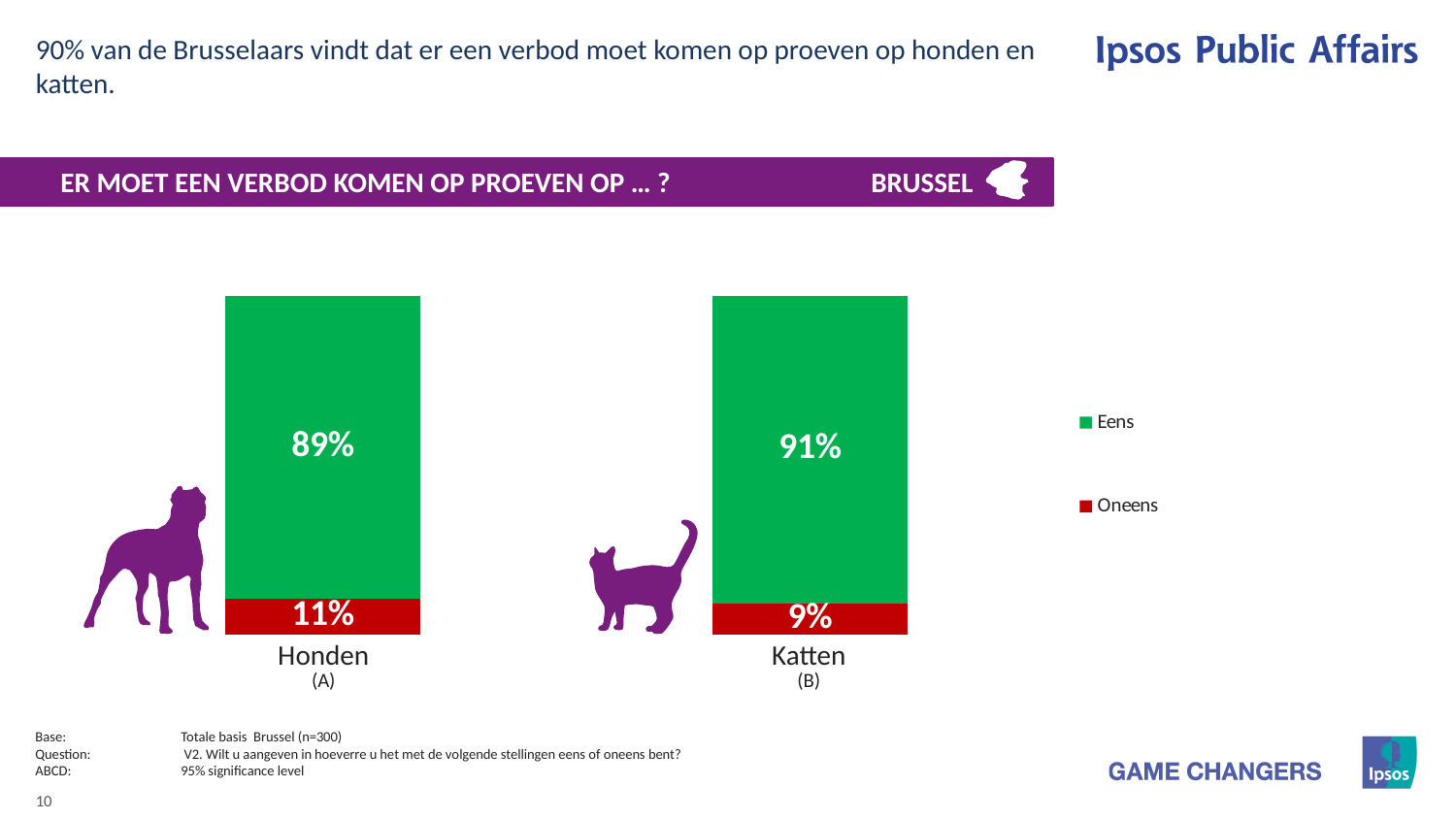
Which colour represents 'Oneens' in the legend? Red Which category has the lowest 'Oneens' value? Katten What is the 'Oneens' value for Katten? 9% How many series does the legend list? 2 What is the 'Eens' value for Honden? 89% Which category has the higher 'Eens' value, Honden or Katten? Katten What is the 'Oneens' value for Honden? 11% What is the difference between the 'Eens' values for Katten and Honden? 2% How many categories are shown on the x axis? 2 What is the total of the stacked bar for Honden? 100% What kind of chart is shown on the slide? Stacked bar chart What is the 'Eens' value for Katten? 91%